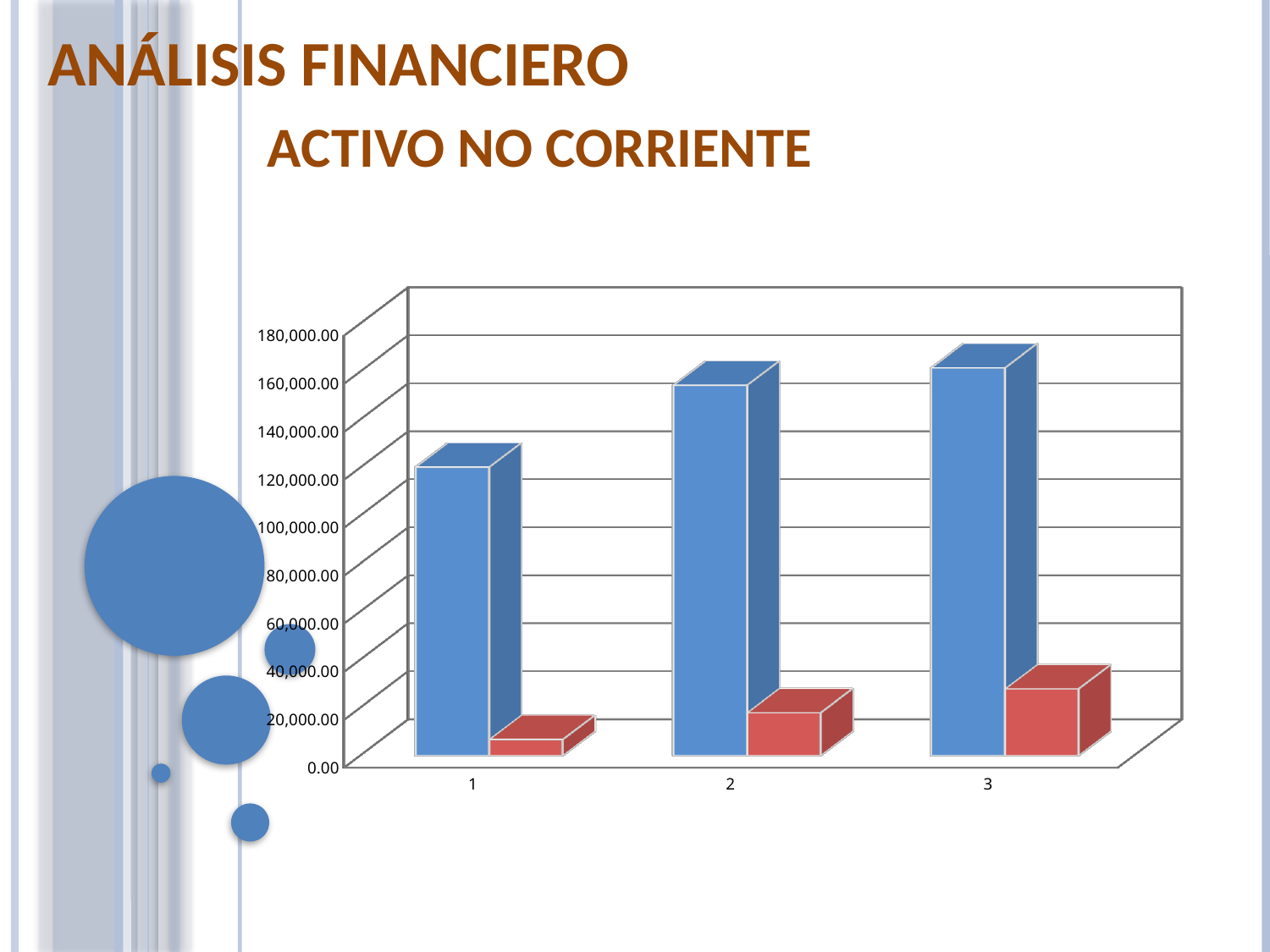
What kind of chart is shown on the slide? bar chart Is the blue bar for category 2 greater or less than 140,000.00? greater In category 1, which bar is larger, the blue one or the red one? the blue one What is the heading shown above the chart? ACTIVO NO CORRIENTE Which category has the shortest blue bar? 1 Is the blue bar for category 1 greater or less than 140,000.00? less Which category has the tallest blue bar? 3 Which category has the tallest red bar? 3 Is the red bar for category 3 greater or less than 40,000.00? less How many categories are shown on the x axis of the chart? 3 How many data series are plotted in the chart? 2 Do the blue bars rise or fall from category 1 to category 3? rise